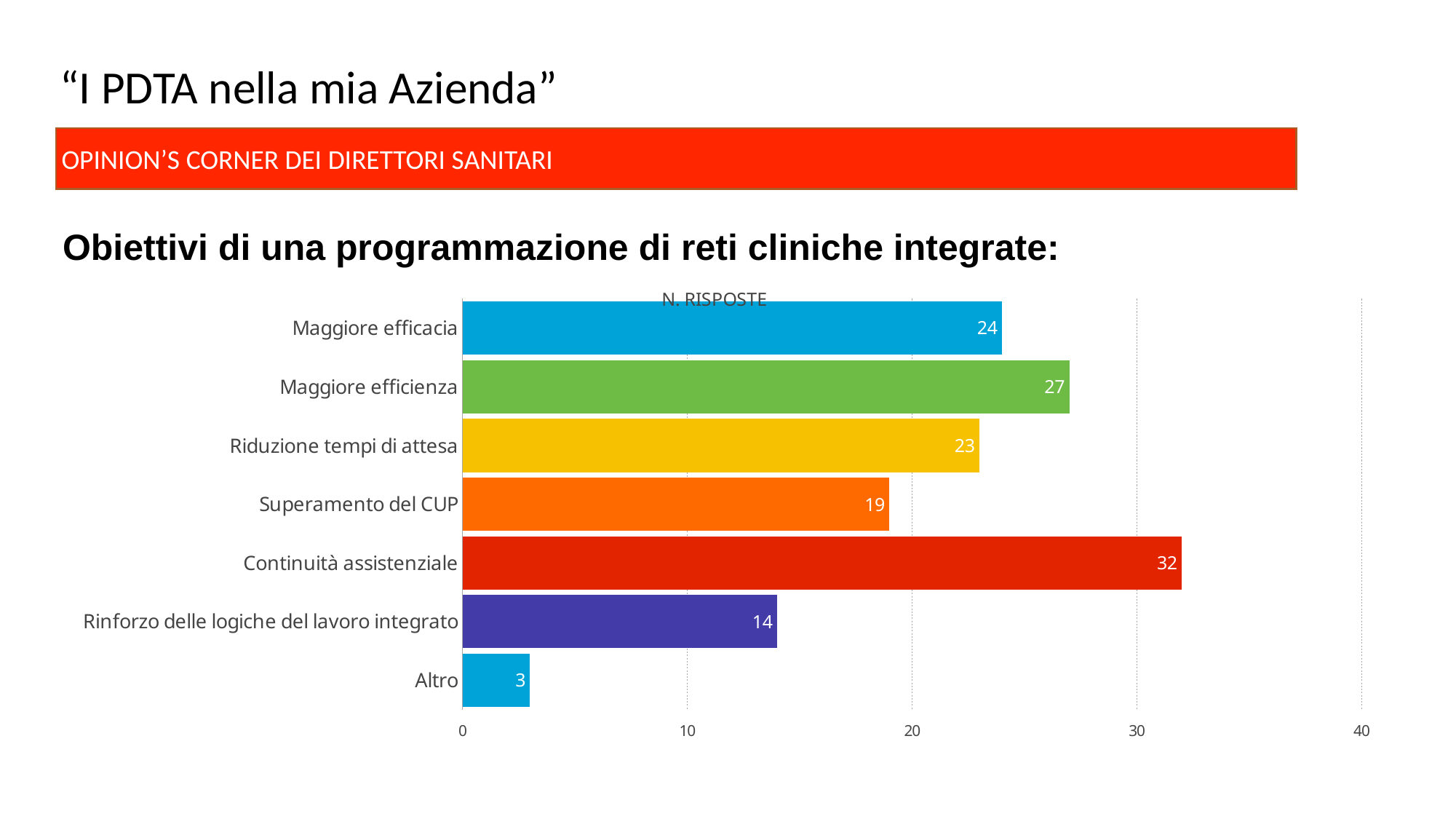
Which is larger, the value for Maggiore efficacia or the value for Riduzione tempi di attesa? Maggiore efficacia How many categories are shown in the chart? 7 What is the value for Superamento del CUP? 19 What kind of chart is shown on the slide? Bar chart Is the value for Maggiore efficienza greater or less than 30? less What is the value for Continuità assistenziale? 32 What is the value for Altro? 3 What is the value for Maggiore efficienza? 27 Which category has the highest value? Continuità assistenziale What is the difference between the values for Continuità assistenziale and Rinforzo delle logiche del lavoro integrato? 18 What is the title of the chart? N. RISPOSTE Which category has the lowest value? Altro